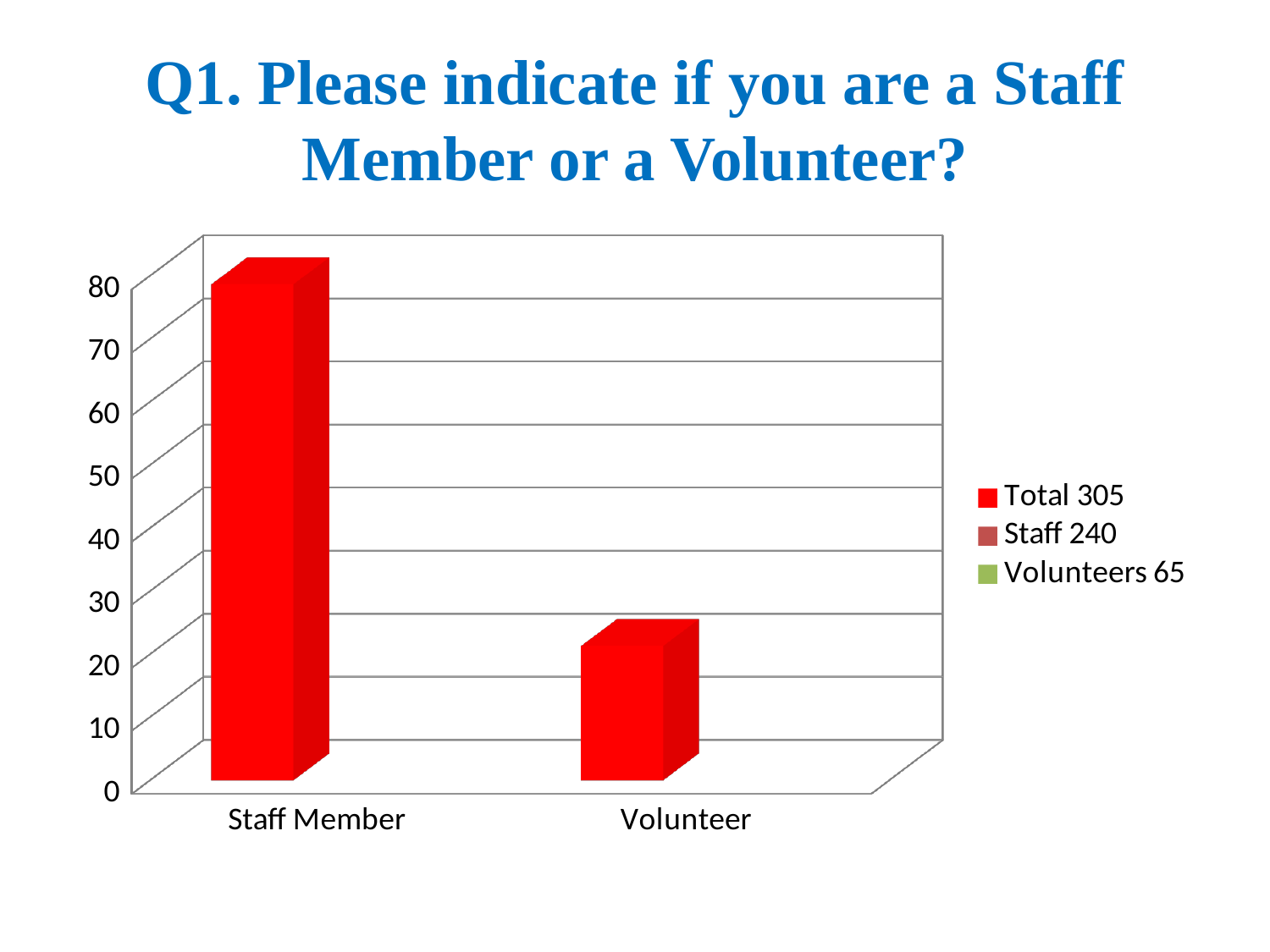
Which bar is taller, Staff Member or Volunteer? Staff Member Is the value for Volunteer greater or less than 30? less Is the value for Staff Member greater or less than 70? greater What kind of chart is shown on the slide? bar chart How many entries does the chart's legend list? 3 Which category has the highest bar in the chart? Staff Member Which category has the lowest bar in the chart? Volunteer Is the value for Volunteer greater or less than 10? greater How many categories are shown on the x axis of the chart? 2 What is the highest value labelled on the vertical axis of the chart? 80 What is the first entry listed in the chart's legend? Total 305